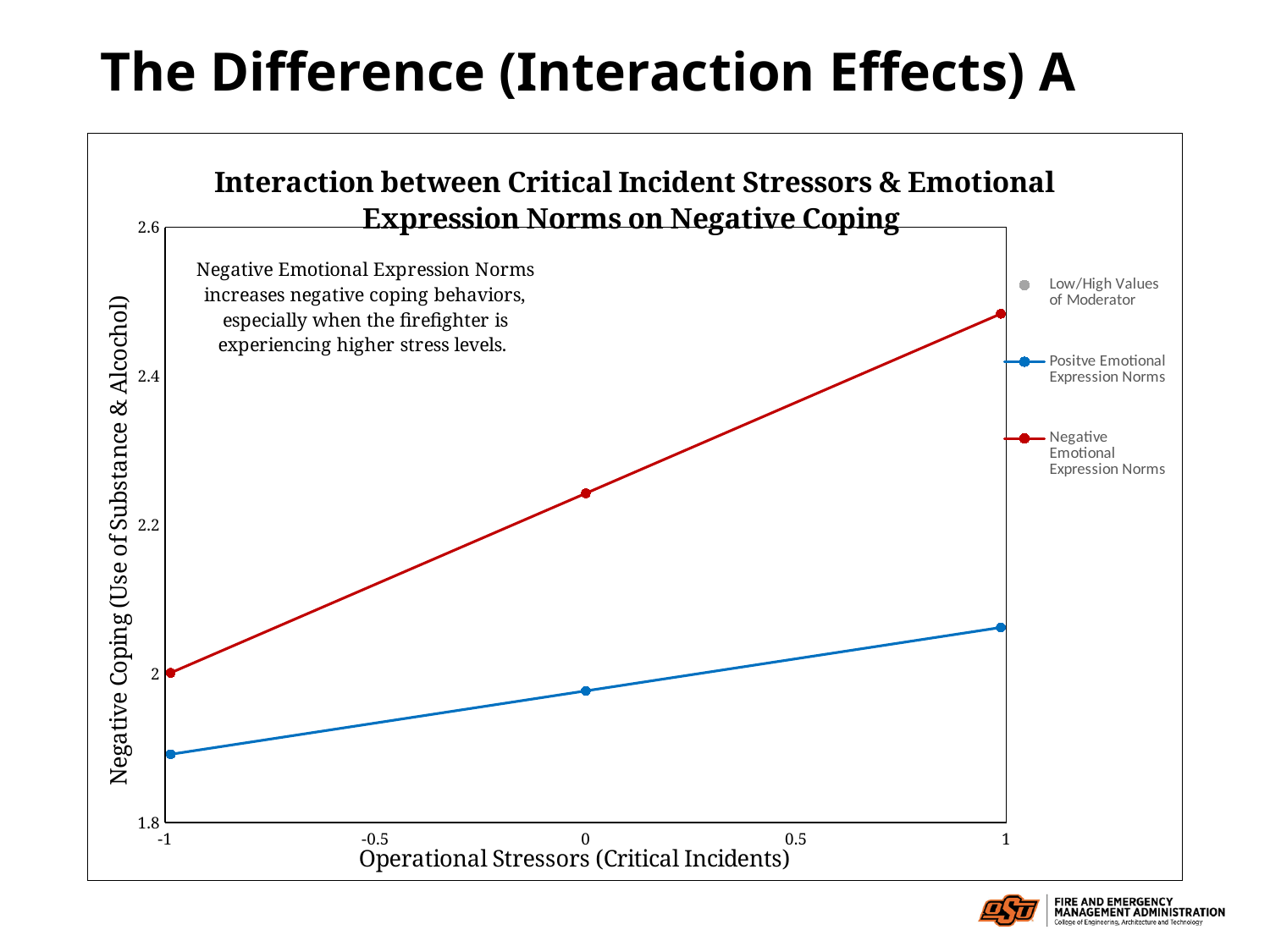
At Operational Stressors = 1, which series has the higher Negative Coping value, Positive Emotional Expression Norms or Negative Emotional Expression Norms? Negative Emotional Expression Norms Is the Positive Emotional Expression Norms value at Operational Stressors = 1 greater or less than 2? greater Is the Positive Emotional Expression Norms value at Operational Stressors = -1 greater or less than 2? less What colour is the line for Negative Emotional Expression Norms? red How many entries does the chart's legend list? 3 What is the label of the chart's x axis? Operational Stressors (Critical Incidents) Is the Negative Emotional Expression Norms value at Operational Stressors = 0 greater or less than 2.2? greater Does the Positive Emotional Expression Norms line rise or fall as Operational Stressors increase from -1 to 1? rise What kind of chart is shown on the slide? line chart Does the Negative Emotional Expression Norms line rise or fall as Operational Stressors increase from -1 to 1? rise How many data points are plotted on the Negative Emotional Expression Norms line? 3